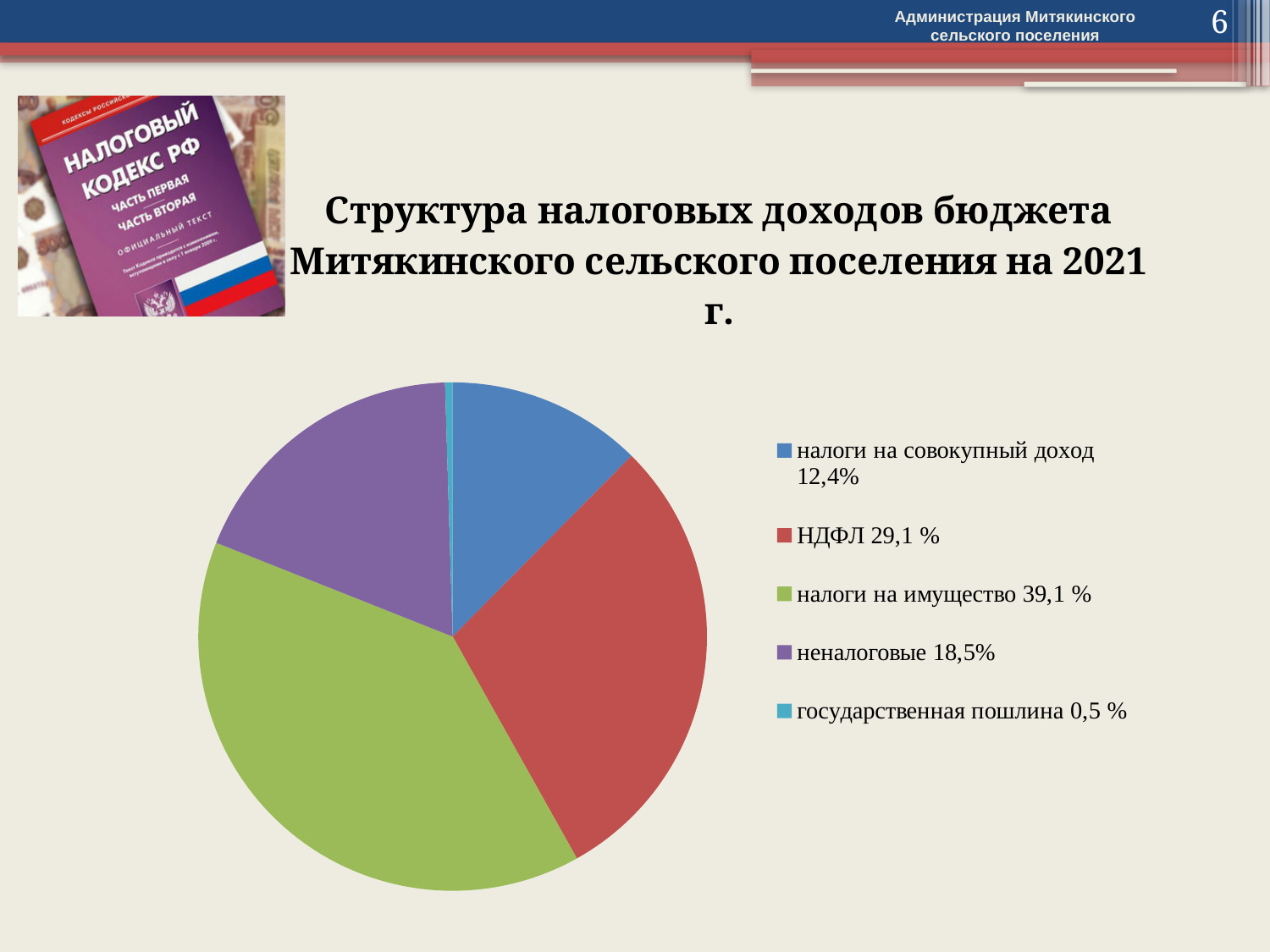
How many slices does the pie chart have? 5 What colour is the slice for неналоговые? purple What is the difference between the share for налоги на имущество and the share for НДФЛ? 10,0 % Which category has the largest share of the pie? налоги на имущество What share of the pie is налоги на имущество? 39,1 % What share of the pie is НДФЛ? 29,1 % Which is larger, the share for НДФЛ or the share for неналоговые? НДФЛ What is the difference between the share for неналоговые and the share for налоги на совокупный доход? 6,1 % Which category has the smallest share of the pie? государственная пошлина What kind of chart is shown on the slide? pie chart What share of the pie is государственная пошлина? 0,5 % What share of the pie is налоги на совокупный доход? 12,4%